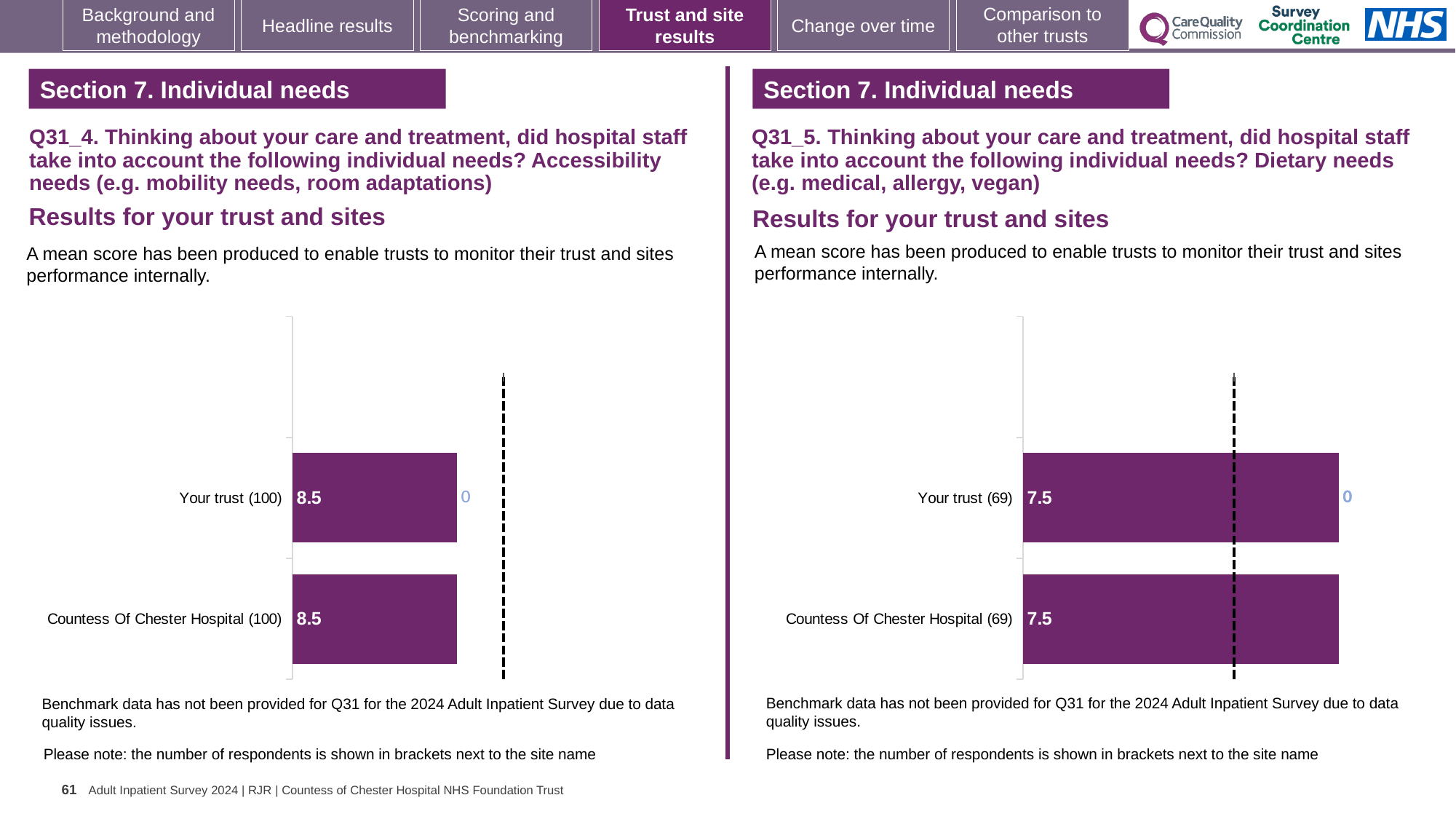
In the Q31_5 Dietary needs chart on the right, what is the mean score for Countess Of Chester Hospital? 7.5 In the Q31_4 Accessibility needs chart on the left, what is the mean score for Countess Of Chester Hospital? 8.5 In the Q31_5 Dietary needs chart on the right, what is the mean score for Your trust? 7.5 What kind of chart is used in the Q31_4 Accessibility needs chart on the left? Bar chart In the Q31_5 Dietary needs chart on the right, how many respondents are shown in brackets for Countess Of Chester Hospital? 69 In the Q31_5 Dietary needs chart on the right, what is the difference between the scores for Your trust and Countess Of Chester Hospital? 0 In the Q31_5 Dietary needs chart on the right, how many categories are shown? 2 In the Q31_4 Accessibility needs chart on the left, what is the mean score for Your trust? 8.5 In the Q31_4 Accessibility needs chart on the left, how many respondents are shown in brackets for Your trust? 100 In the Q31_4 Accessibility needs chart on the left, what is the difference between the scores for Your trust and Countess Of Chester Hospital? 0 In the Q31_4 Accessibility needs chart on the left, how many bars are plotted? 2